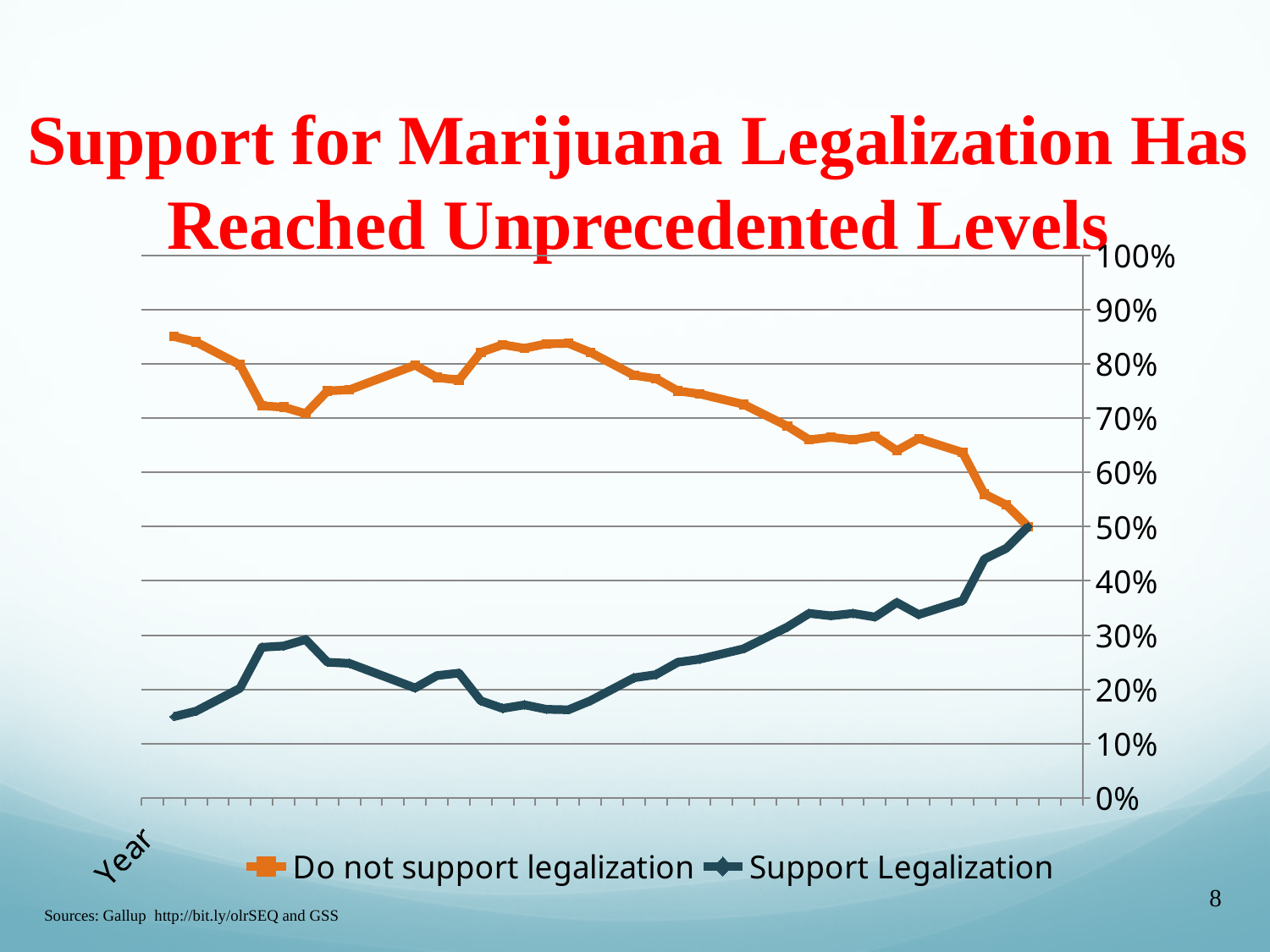
What is the label on the x axis? Year How many series does the legend list? 2 At the left end of the chart, which series is higher: Do not support legalization or Support Legalization? Do not support legalization Is the first value for Do not support legalization greater or less than 80%? greater Which series reaches the highest value anywhere on the chart? Do not support legalization Is the first value for Support Legalization greater or less than 20%? less What kind of chart is shown on the slide? line chart Does the Support Legalization line generally rise or fall from left to right? rise At what value do the two lines meet at the right end of the chart? 50% Is the final value for Do not support legalization greater or less than 60%? less Does the Do not support legalization line generally rise or fall from left to right? fall What are the two series named in the legend? Do not support legalization; Support Legalization